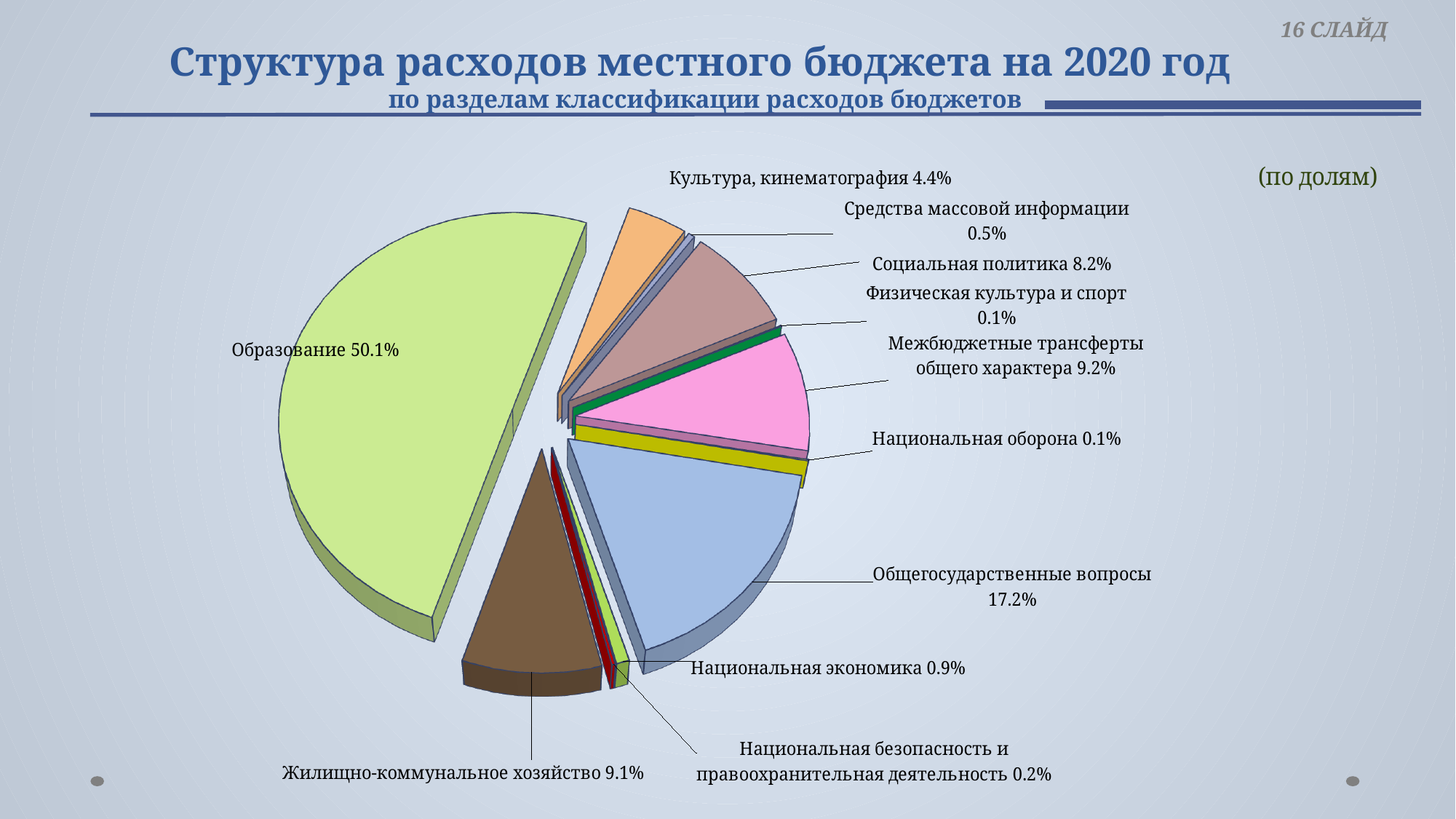
What is the difference between the shares of Общегосударственные вопросы and Социальная политика? 9.0% Which category has the largest share of the pie? Образование What share is shown for Национальная безопасность и правоохранительная деятельность? 0.2% What is the value shown for Общегосударственные вопросы? 17.2% What type of chart is shown on the slide? Pie chart What percentage is labelled for Межбюджетные трансферты общего характера? 9.2% How many categories (slices) does the pie chart show? 11 Which is larger: the share for Социальная политика or the share for Жилищно-коммунальное хозяйство? Жилищно-коммунальное хозяйство What is the main title of the slide? Структура расходов местного бюджета на 2020 год What share of the local budget expenditure goes to Образование? 50.1% Which is larger: the share for Культура, кинематография or the share for Национальная экономика? Культура, кинематография What is the difference between the shares of Межбюджетные трансферты общего характера and Жилищно-коммунальное хозяйство? 0.1%